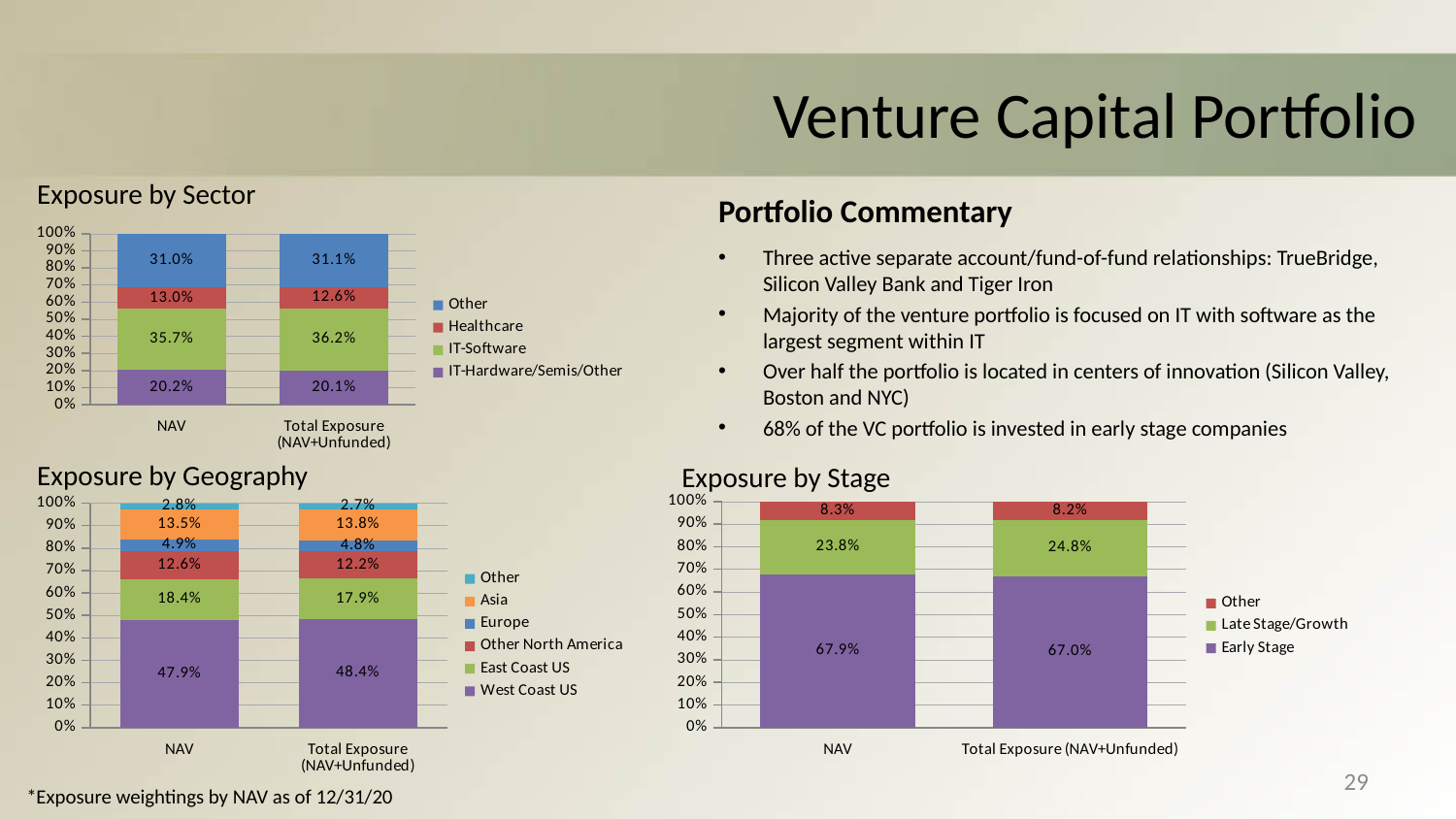
In the Exposure by Geography chart, what is the West Coast US value for Total Exposure (NAV+Unfunded)? 48.4% In the Exposure by Geography chart, how many series does the legend list? 6 In the Exposure by Sector chart, what is the Healthcare value for Total Exposure (NAV+Unfunded)? 12.6% In the Exposure by Sector chart, how many series does the legend list? 4 In the Exposure by Stage chart, how many categories are shown on the x axis? 2 In the Exposure by Sector chart, what is the IT-Software value for NAV? 35.7% In the Exposure by Geography chart, what is the difference between the East Coast US values for NAV and Total Exposure (NAV+Unfunded)? 0.5% What kind of chart is the Exposure by Stage chart? Stacked bar chart In the Exposure by Sector chart, which sector has the largest share of the NAV bar? IT-Software In the Exposure by Stage chart, which is larger: Late Stage/Growth for NAV or Late Stage/Growth for Total Exposure (NAV+Unfunded)? Total Exposure (NAV+Unfunded) In the Exposure by Geography chart, which region has the smallest share of the NAV bar? Other In the Exposure by Stage chart, what is the Early Stage value for NAV? 67.9%